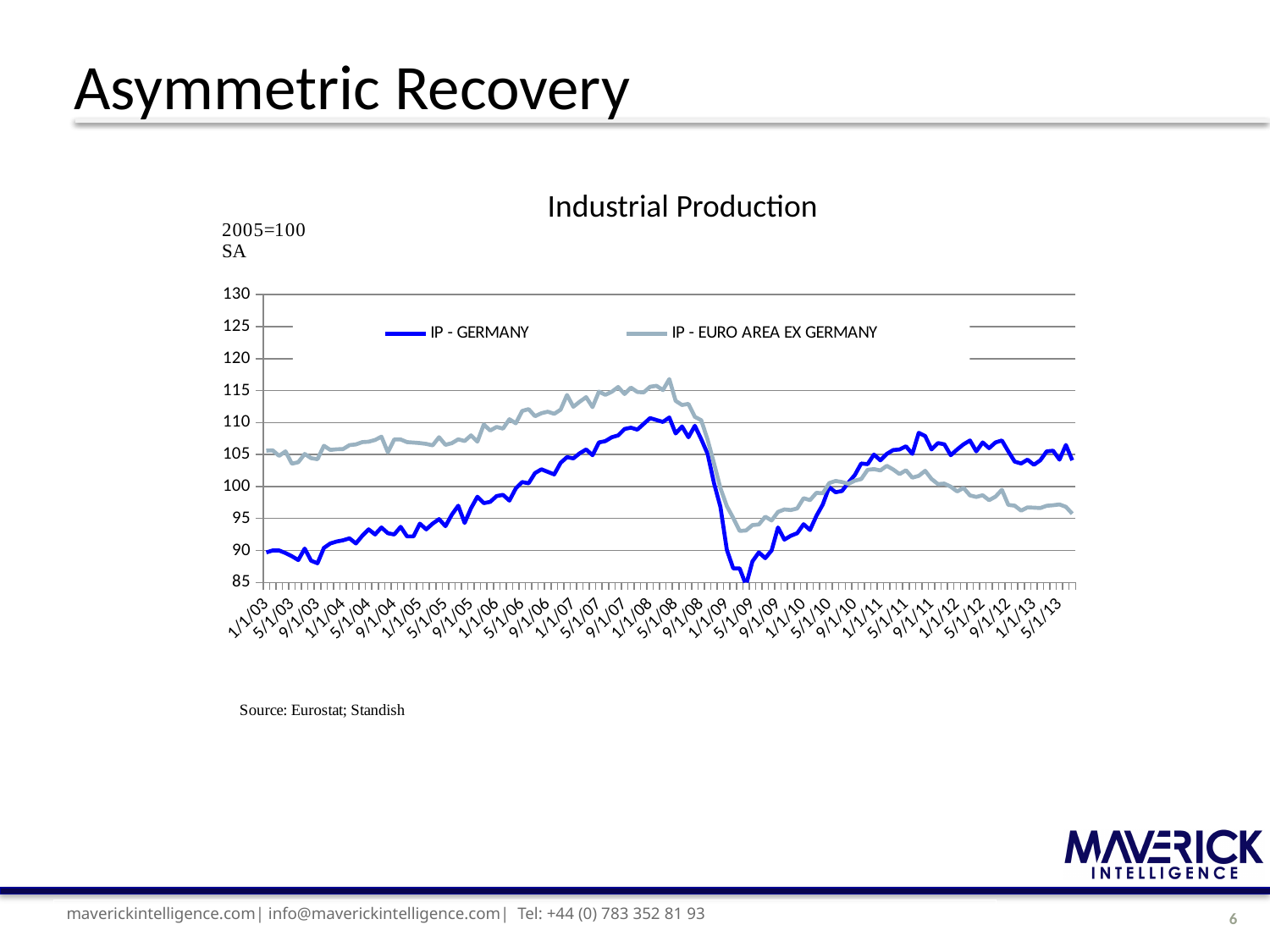
Does the IP - EURO AREA EX GERMANY series generally rise or fall between 1/1/11 and 5/1/13? fall Is the value for IP - GERMANY at 1/1/03 greater or less than 95? less Which series is drawn in dark blue in the chart? IP - GERMANY At 5/1/13, which series has the higher value, IP - GERMANY or IP - EURO AREA EX GERMANY? IP - GERMANY Is the value for IP - GERMANY at 5/1/13 greater or less than 100? greater At 1/1/03, which series has the higher value, IP - GERMANY or IP - EURO AREA EX GERMANY? IP - EURO AREA EX GERMANY What is the title of the chart? Industrial Production Is the value for IP - EURO AREA EX GERMANY at 1/1/03 greater or less than 100? greater What kind of chart is shown on the slide? line chart How many series does the chart's legend list? 2